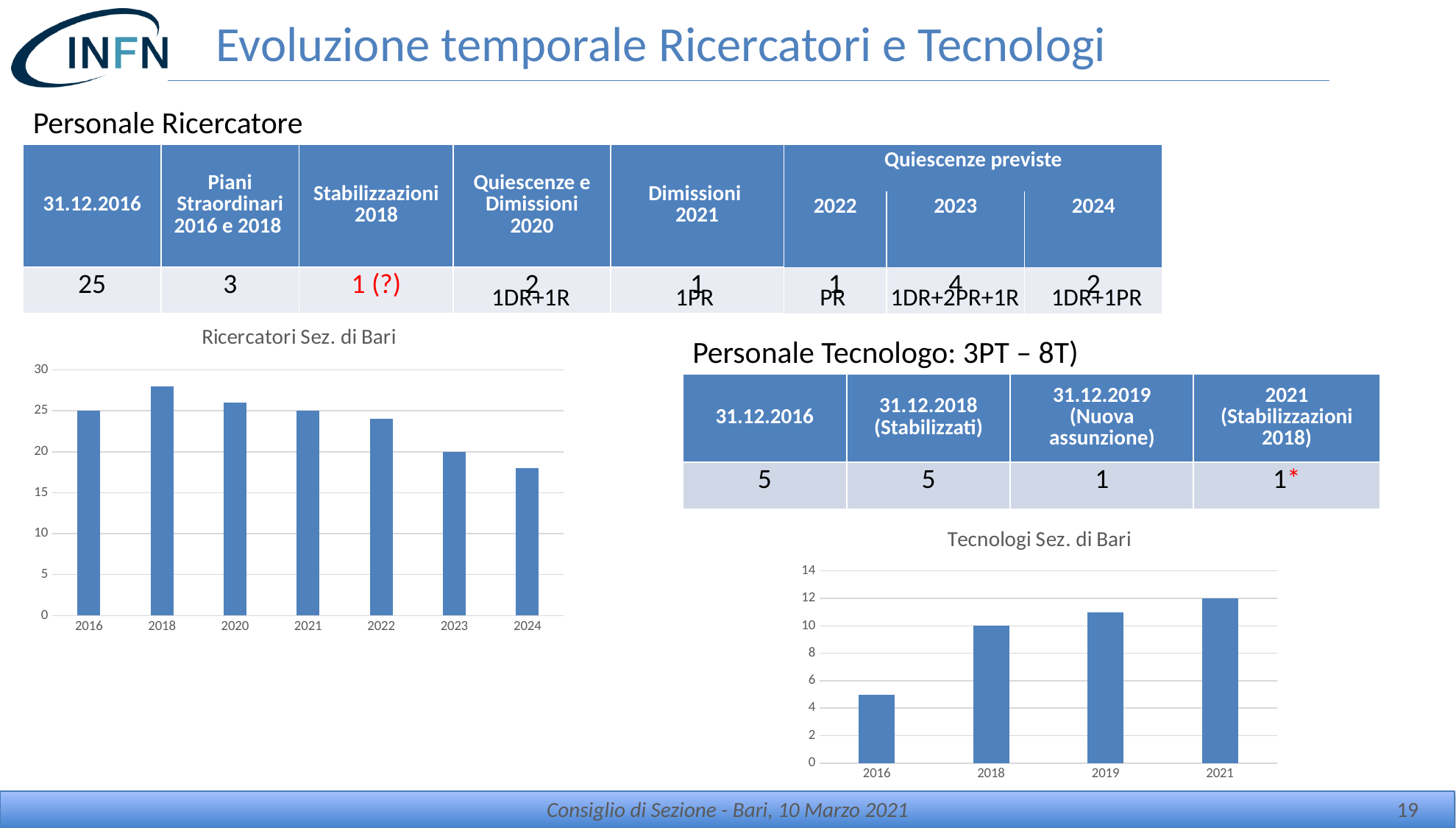
What kind of chart is 'Tecnologi Sez. di Bari'? bar chart In the 'Ricercatori Sez. di Bari' chart, do the values rise or fall from 2021 to 2024? fall In the 'Ricercatori Sez. di Bari' chart, how many years are shown on the x axis? 7 In the 'Tecnologi Sez. di Bari' chart, what is the value for 2021? 12 In the 'Ricercatori Sez. di Bari' chart, is the value for 2024 greater or less than 20? less In the 'Ricercatori Sez. di Bari' chart, what is the difference between the values for 2016 and 2023? 5 In the 'Ricercatori Sez. di Bari' chart, what is the value for 2023? 20 In the 'Ricercatori Sez. di Bari' chart, which year has the highest bar? 2018 In the 'Tecnologi Sez. di Bari' chart, do the values rise or fall from 2016 to 2021? rise In the 'Tecnologi Sez. di Bari' chart, what is the value for 2018? 10 In the 'Ricercatori Sez. di Bari' chart, what is the value for 2016? 25 In the 'Ricercatori Sez. di Bari' chart, which year has the lowest bar? 2024